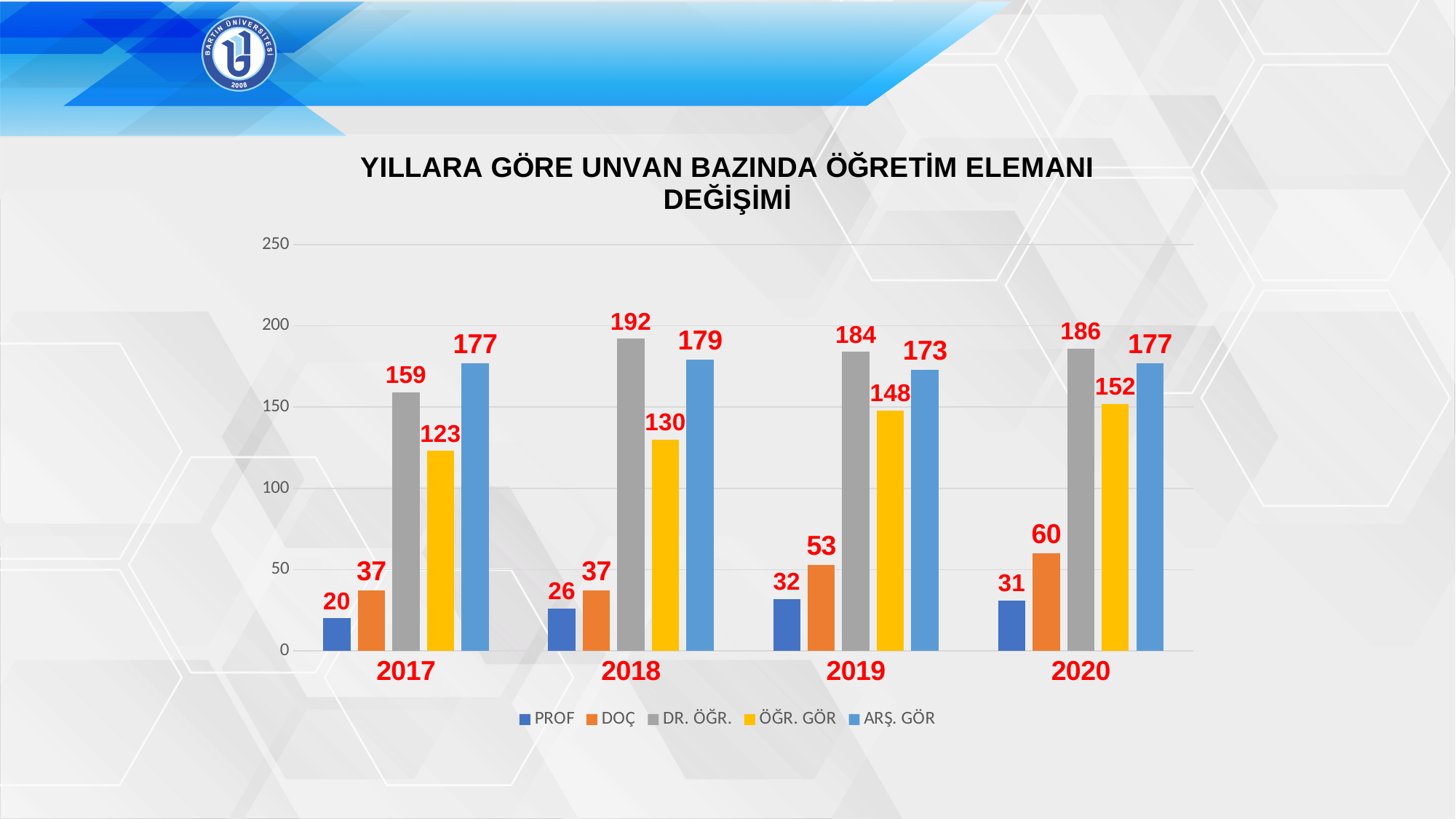
What kind of chart is shown on the slide? bar chart How many series does the legend list? 5 Which is larger in 2020: DR. ÖĞR. or ARŞ. GÖR? DR. ÖĞR. What is the value for ÖĞR. GÖR in 2019? 148 In which year is the PROF value lowest? 2017 What is the value for DR. ÖĞR. in 2018? 192 What is the difference between the ARŞ. GÖR values in 2018 and 2019? 6 What is the value for PROF in 2017? 20 What is the value for DOÇ in 2020? 60 In which year is the DOÇ value highest? 2020 Is the value for ÖĞR. GÖR in 2017 greater or less than 150? less How many years are shown on the x axis? 4